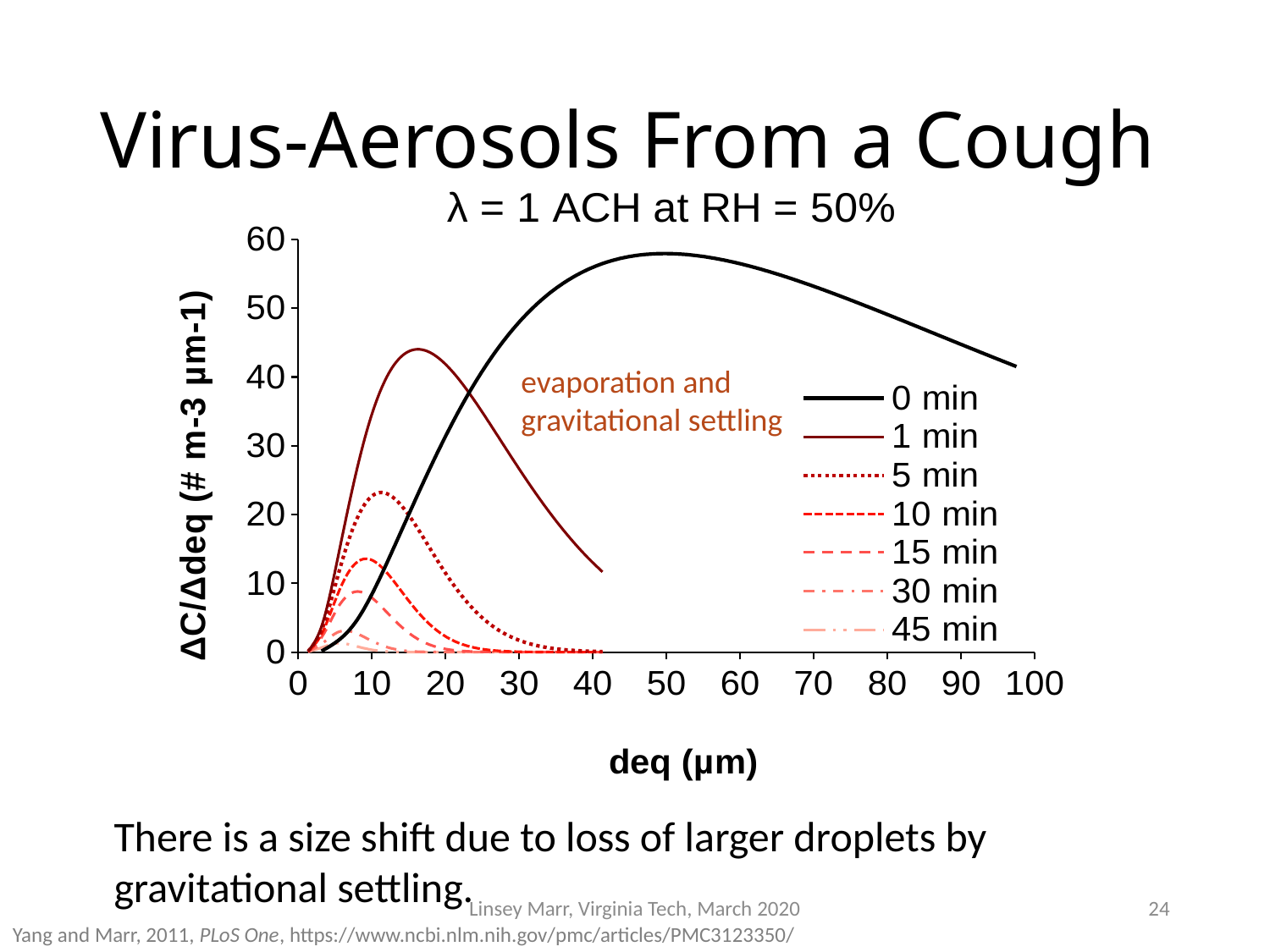
What is the label of the x axis? deq (μm) Is the peak value of the 5 min curve greater or less than 20? greater Is the peak value of the 1 min curve greater or less than 40? greater Which series has the lowest peak value? 45 min How many series does the chart legend list? 7 Does the 0 min curve rise or fall as deq increases from 60 to 100 μm? fall Which series reaches the highest peak value? 0 min Is the peak value of the 10 min curve greater or less than 20? less What is the title of the chart? λ = 1 ACH at RH = 50% What kind of chart is shown on the slide? line chart Which series has a higher peak, 1 min or 5 min? 1 min